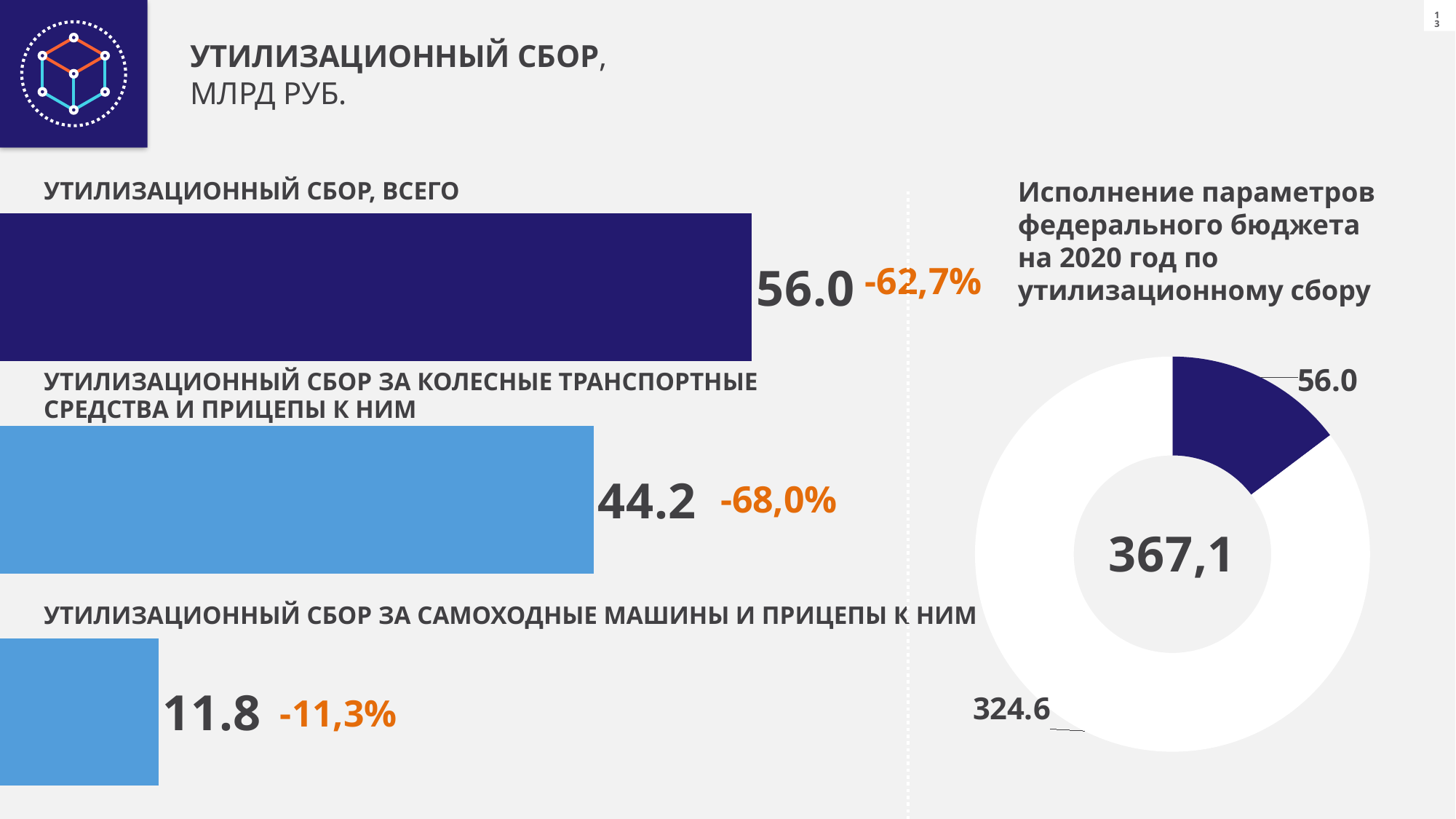
In the bar chart on the left, what percentage change is shown next to the 'за самоходные машины и прицепы к ним' bar? -11,3% What kind of chart is shown on the right side of the slide? Donut chart In the bar chart on the left, which category has the lowest value? Утилизационный сбор за самоходные машины и прицепы к ним In the bar chart on the left, what is the value for 'Утилизационный сбор, всего'? 56.0 In the bar chart on the left, how many bars are shown? 3 In the bar chart on the left, what is the value for 'Утилизационный сбор за самоходные машины и прицепы к ним'? 11.8 In the donut chart on the right, what is the value of the larger (white) segment? 324.6 In the donut chart on the right, what value is shown in the centre? 367,1 In the bar chart on the left, what is the value for 'Утилизационный сбор за колесные транспортные средства и прицепы к ним'? 44.2 In the bar chart on the left, what is the difference between the values for колесные транспортные средства (44.2) and самоходные машины (11.8)? 32.4 What kind of chart is shown on the left side of the slide? Bar chart In the bar chart on the left, what percentage change is shown next to the 'Утилизационный сбор, всего' bar? -62,7%